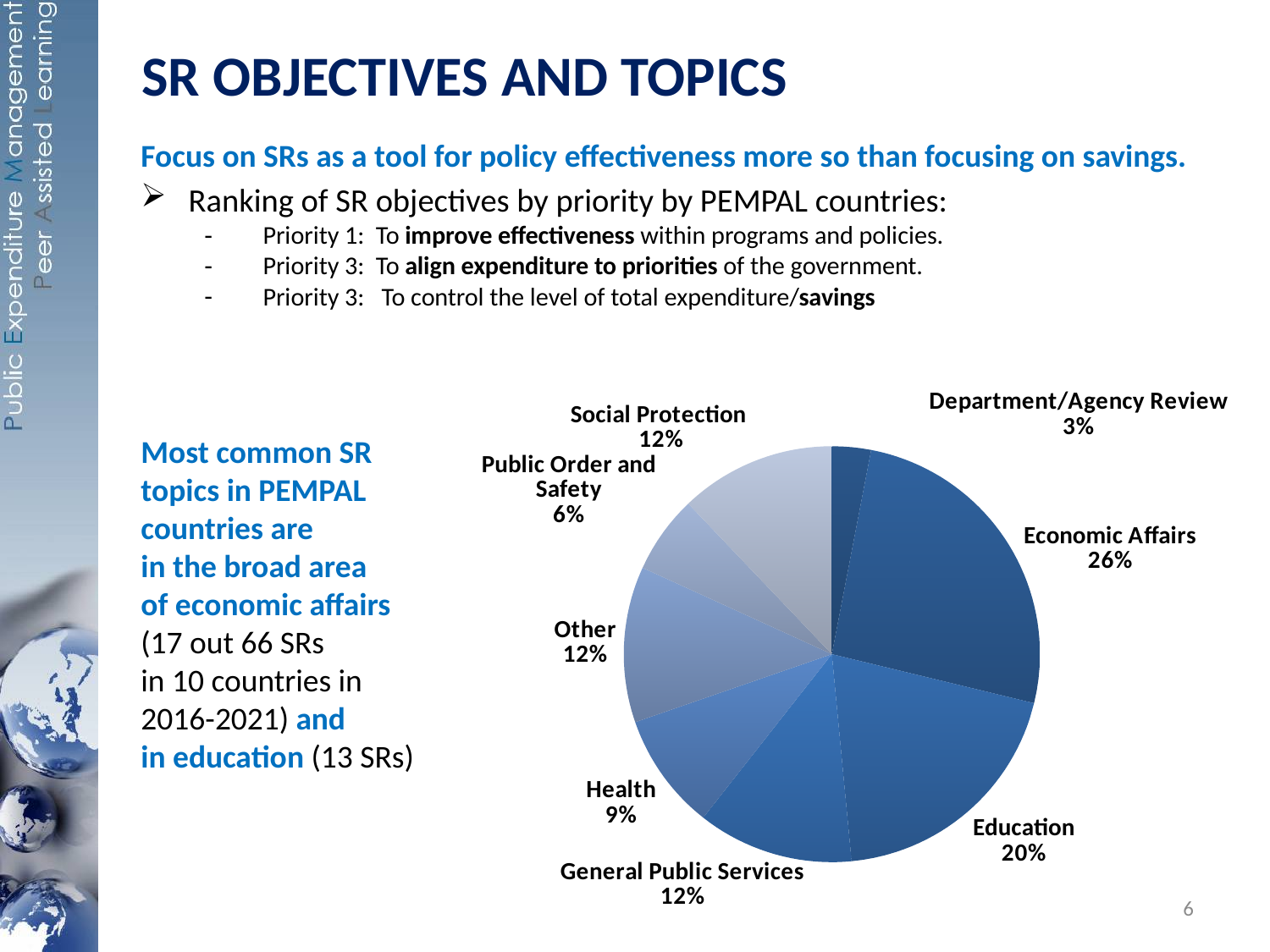
Which category has the smallest slice of the pie? Department/Agency Review What is the difference between the shares of Social Protection and Department/Agency Review? 9% What is the value shown for Health? 9% What share of the pie does Economic Affairs have? 26% Which is larger, the share for Health or the share for General Public Services? General Public Services What is the value shown for Education? 20% What kind of chart is shown on the slide? pie chart What is the difference between the shares of Economic Affairs and Education? 6% Which categories share the same value of 12%? Social Protection, Other, General Public Services Which category has the largest slice of the pie? Economic Affairs What is the value shown for Public Order and Safety? 6% How many slices does the pie chart have? 8